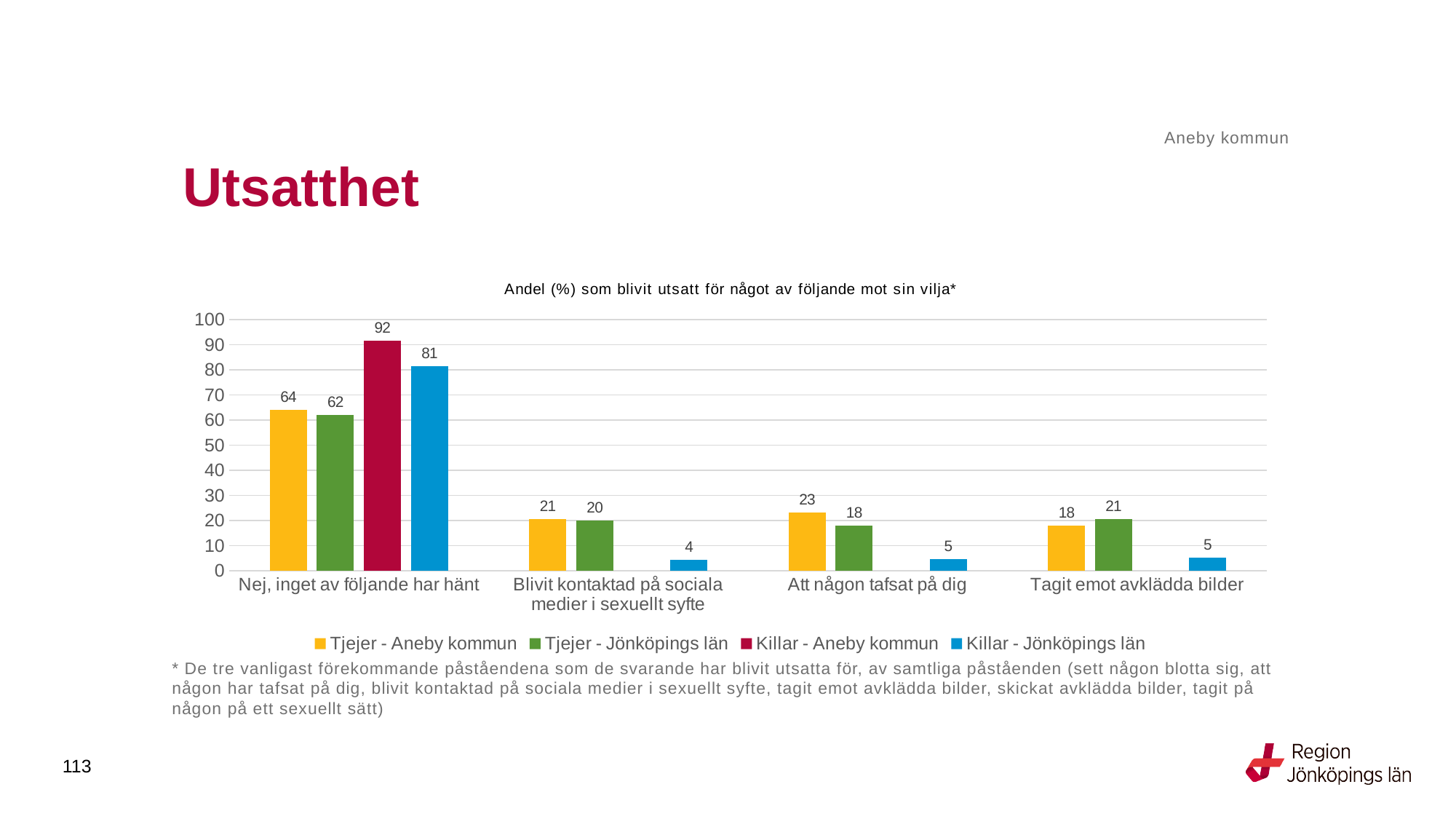
What is the value for Killar - Aneby kommun in the category 'Nej, inget av följande har hänt'? 92 How many categories are shown on the x axis? 4 Is the value for Tjejer - Aneby kommun in 'Att någon tafsat på dig' greater or less than 20? greater What is the title of the chart? Andel (%) som blivit utsatt för något av följande mot sin vilja* What kind of chart is shown on the slide? bar chart In the category 'Tagit emot avklädda bilder', which is larger: Tjejer - Aneby kommun or Tjejer - Jönköpings län? Tjejer - Jönköpings län How many series does the legend list? 4 What is the value for Tjejer - Jönköpings län in the category 'Att någon tafsat på dig'? 18 Which series has the lowest value in the category 'Tagit emot avklädda bilder'? Killar - Jönköpings län What is the value for Killar - Jönköpings län in the category 'Blivit kontaktad på sociala medier i sexuellt syfte'? 4 Which series has the highest value in the category 'Nej, inget av följande har hänt'? Killar - Aneby kommun What is the difference between Killar - Aneby kommun and Killar - Jönköpings län in the category 'Nej, inget av följande har hänt'? 11